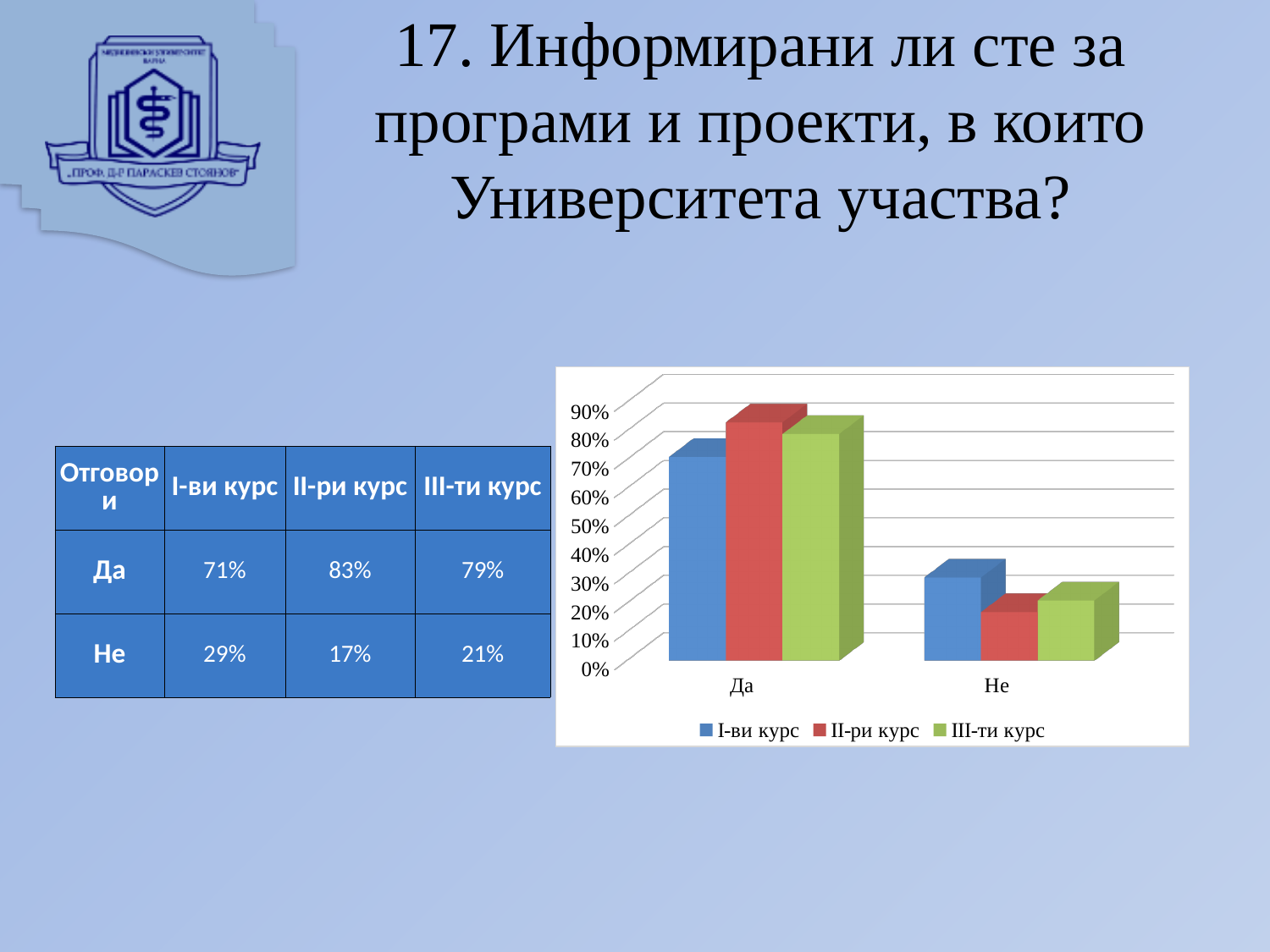
What is the difference between the Да values for II-ри курс and I-ви курс? 12% How many categories are shown on the x axis of the chart? 2 How many series does the chart legend list? 3 What kind of chart is shown on the slide? bar chart Is the value for II-ри курс in the Не category greater or less than 20%? less Which series has the highest value in the Да category? II-ри курс What is the value for III-ти курс in the Да category? 79% Which series has the lowest value in the Не category? II-ри курс What is the value for II-ри курс in the Да category? 83% Which colour represents III-ти курс in the chart legend? green Is the value for I-ви курс in the Да category greater or less than 60%? greater What is the value for I-ви курс in the Не category? 29%